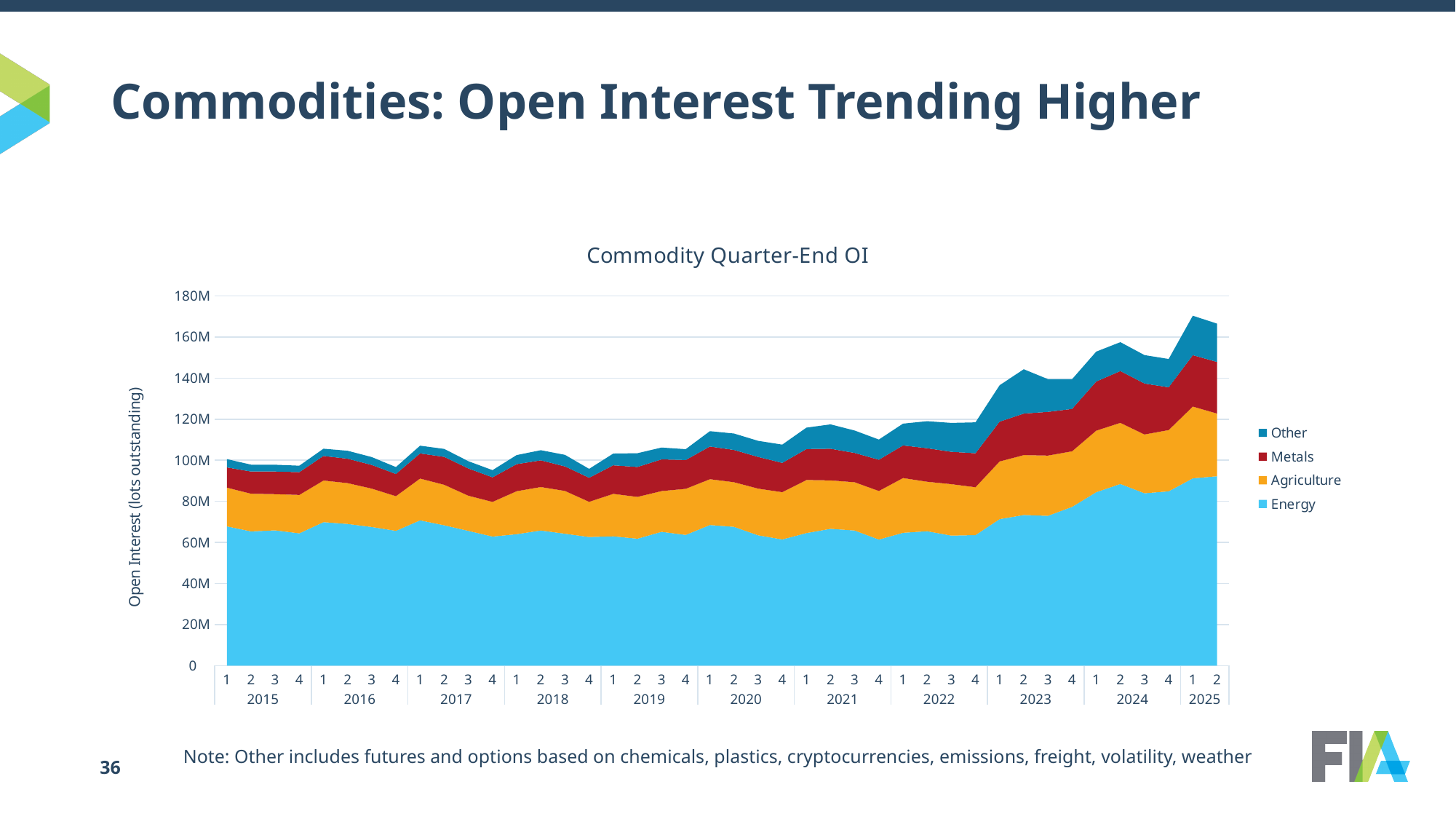
Is the total open interest in quarter 1 of 2020 greater or less than 100M? greater Is the total open interest higher in quarter 1 of 2025 or in quarter 1 of 2015? Quarter 1 of 2025 What is the label on the vertical axis? Open Interest (lots outstanding) What is the title of the chart? Commodity Quarter-End OI Is the Energy open interest in quarter 1 of 2015 greater or less than 80M? less What kind of chart is shown on the slide? Stacked area chart Is the Energy open interest in quarter 2 of 2025 greater or less than 80M? greater How many years are labeled on the x axis? 11 Which series accounts for the largest share of open interest throughout the chart? Energy How many series does the legend list? 4 Does total commodity open interest generally rise or fall from 2015 to 2025? Rise